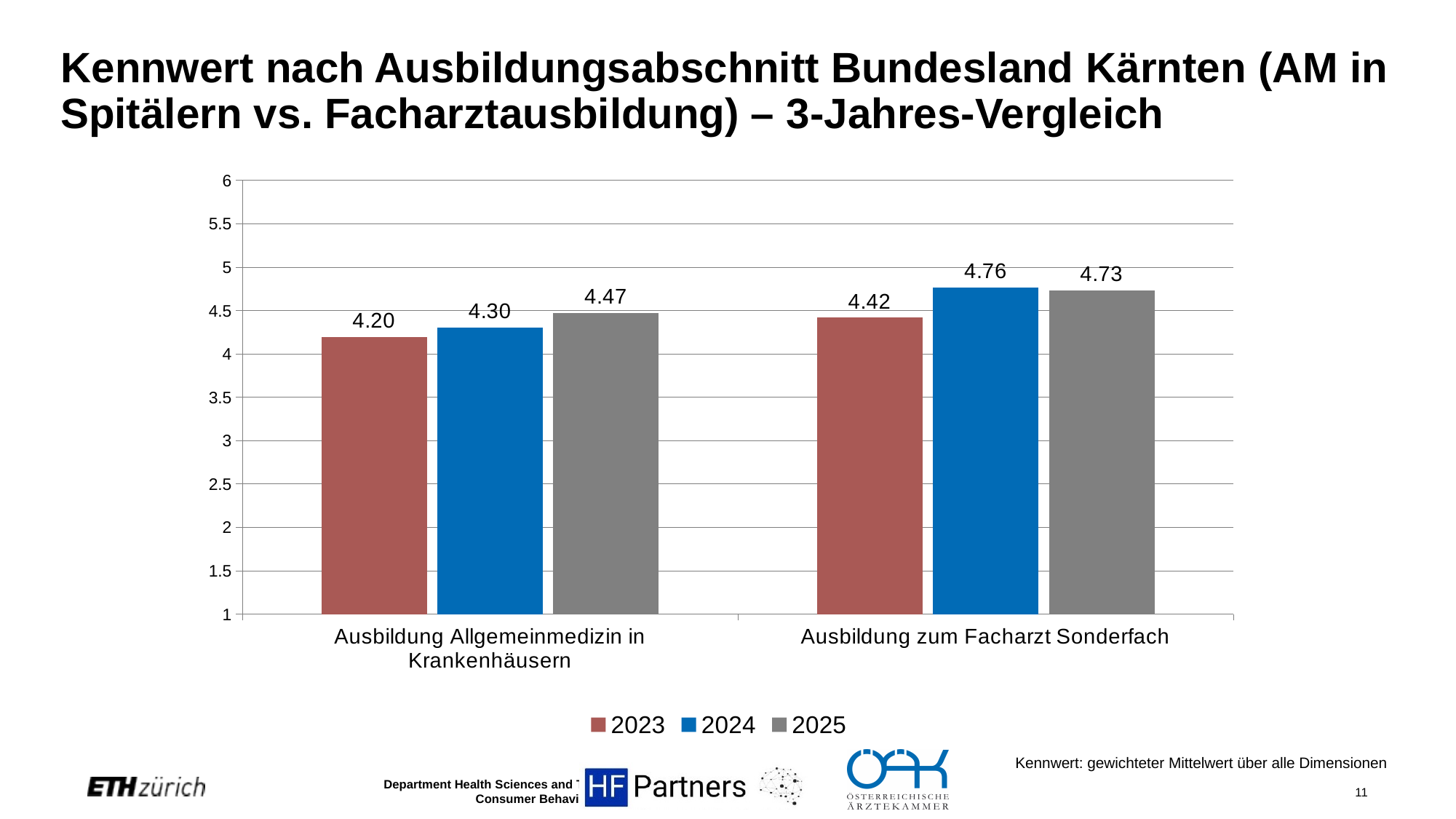
Is the 2024 value for Ausbildung zum Facharzt Sonderfach greater or less than 4.5? greater What is the value for 2025 for Ausbildung zum Facharzt Sonderfach? 4.73 Which year has the highest value for Ausbildung zum Facharzt Sonderfach? 2024 Do the values for Ausbildung Allgemeinmedizin in Krankenhäusern rise or fall from 2023 to 2025? rise What is the value for 2023 for Ausbildung Allgemeinmedizin in Krankenhäusern? 4.20 What is the value for 2024 for Ausbildung Allgemeinmedizin in Krankenhäusern? 4.30 Which year has the lowest value for Ausbildung Allgemeinmedizin in Krankenhäusern? 2023 What is the difference between the 2025 and 2023 values for Ausbildung Allgemeinmedizin in Krankenhäusern? 0.27 Which is larger: the 2023 value for Ausbildung zum Facharzt Sonderfach or the 2023 value for Ausbildung Allgemeinmedizin in Krankenhäusern? Ausbildung zum Facharzt Sonderfach How many categories are shown on the x axis? 2 What kind of chart is shown on the slide? bar chart How many series does the legend list? 3